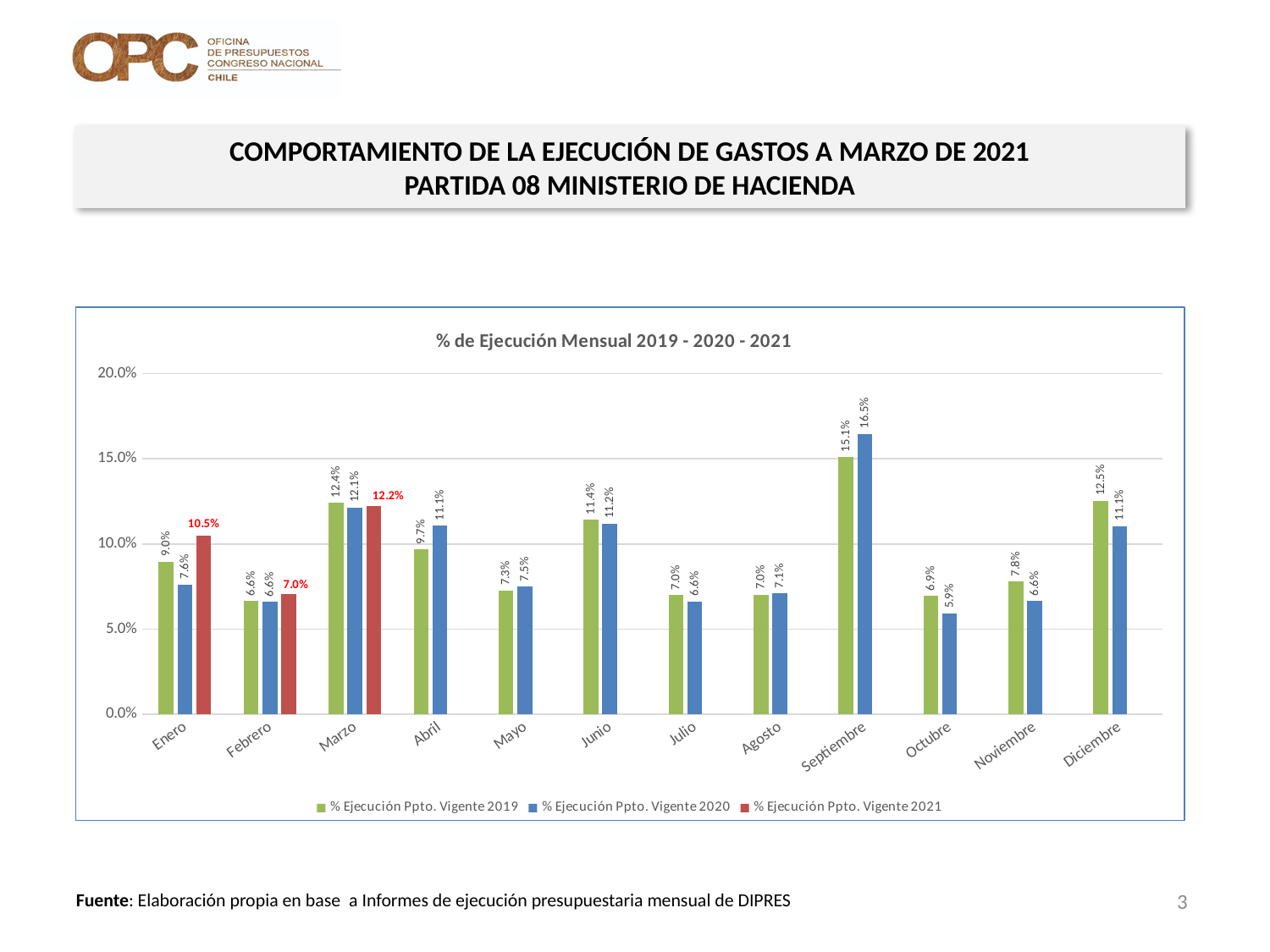
What kind of chart is shown on the slide? Bar chart Which month has the highest value for % Ejecución Ppto. Vigente 2019? Septiembre What is the value of % Ejecución Ppto. Vigente 2019 for Diciembre? 12.5% Which is larger for Abril: the 2019 value or the 2020 value? 2020 value (11.1%) Which month has the lowest value for % Ejecución Ppto. Vigente 2020? Octubre What is the value of % Ejecución Ppto. Vigente 2020 for Septiembre? 16.5% What is the value of % Ejecución Ppto. Vigente 2021 for Enero? 10.5% How many months are shown on the x axis? 12 What is the title of the chart? % de Ejecución Mensual 2019 - 2020 - 2021 Is the value for % Ejecución Ppto. Vigente 2019 in Marzo greater or less than 10.0%? greater What is the difference between the 2020 and 2019 values for Septiembre? 1.4% How many series does the legend list? 3